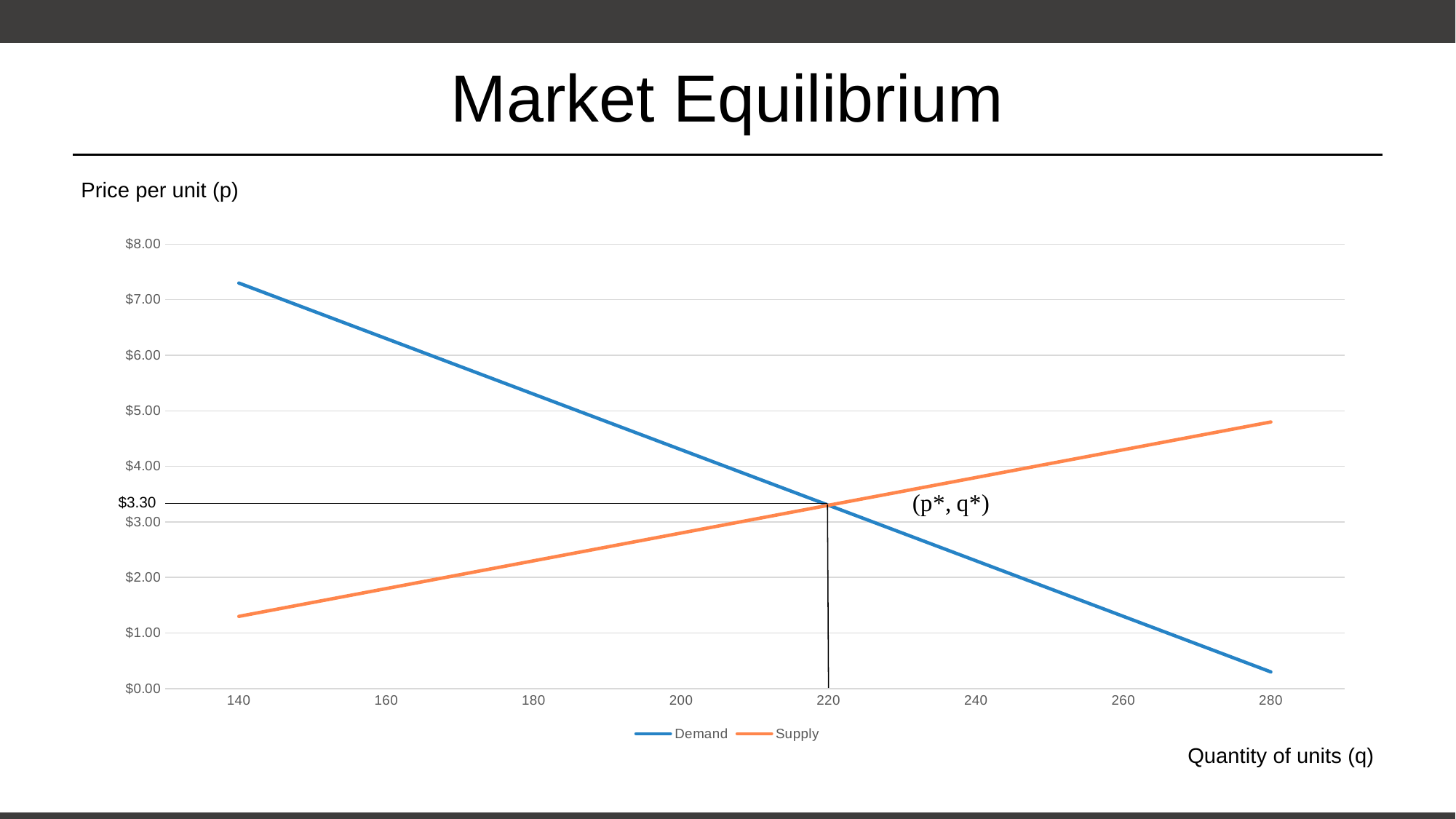
Is the Demand value at quantity 280 greater or less than $1.00? less Is the Demand value at quantity 140 greater or less than $7.00? greater Does the Supply line rise or fall as quantity increases along the x axis? rise At quantity 160, which line is higher, Demand or Supply? Demand Does the Demand line rise or fall as quantity increases along the x axis? fall What are the two series named in the legend? Demand and Supply What kind of chart is shown on the slide? line chart What is the price at which the Demand and Supply lines intersect? $3.30 How many series does the legend list? 2 At quantity 260, which line is higher, Demand or Supply? Supply Is the Supply value at quantity 140 greater or less than $2.00? less At what quantity do the Demand and Supply lines intersect? 220